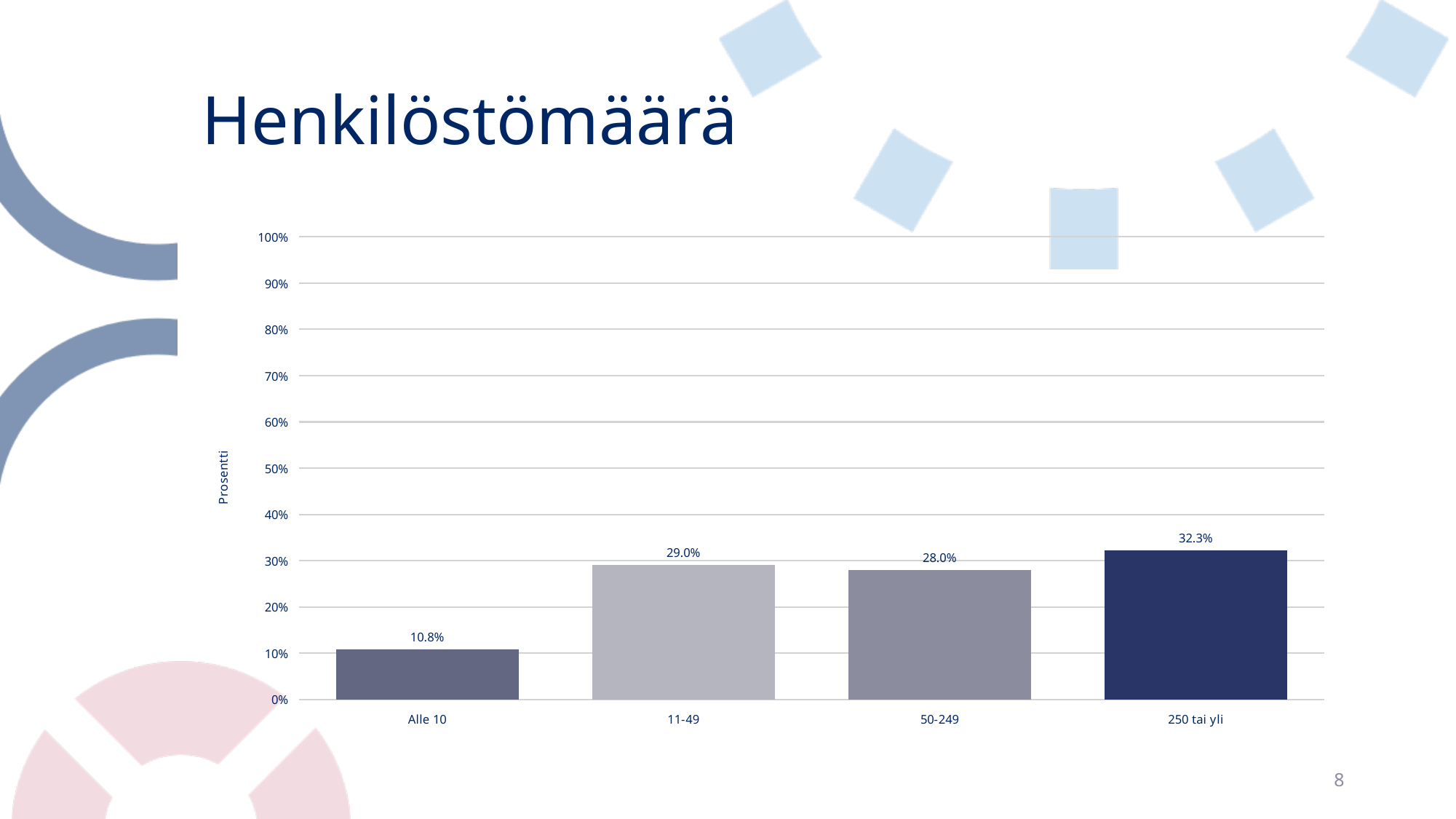
What is the difference between the values for '11-49' and '50-249'? 1.0% What is the value for the 'Alle 10' category? 10.8% Which category has the lowest value? Alle 10 Is the value for '50-249' greater or less than 30%? less Which category has the highest value? 250 tai yli What kind of chart is shown on the slide? bar chart How many categories are shown on the x axis? 4 What is the difference between the values for '250 tai yli' and 'Alle 10'? 21.5% What is the value for the '250 tai yli' category? 32.3% What is the value for the '11-49' category? 29.0% What is the value for the '50-249' category? 28.0% Which is larger, the value for '11-49' or the value for '250 tai yli'? 250 tai yli